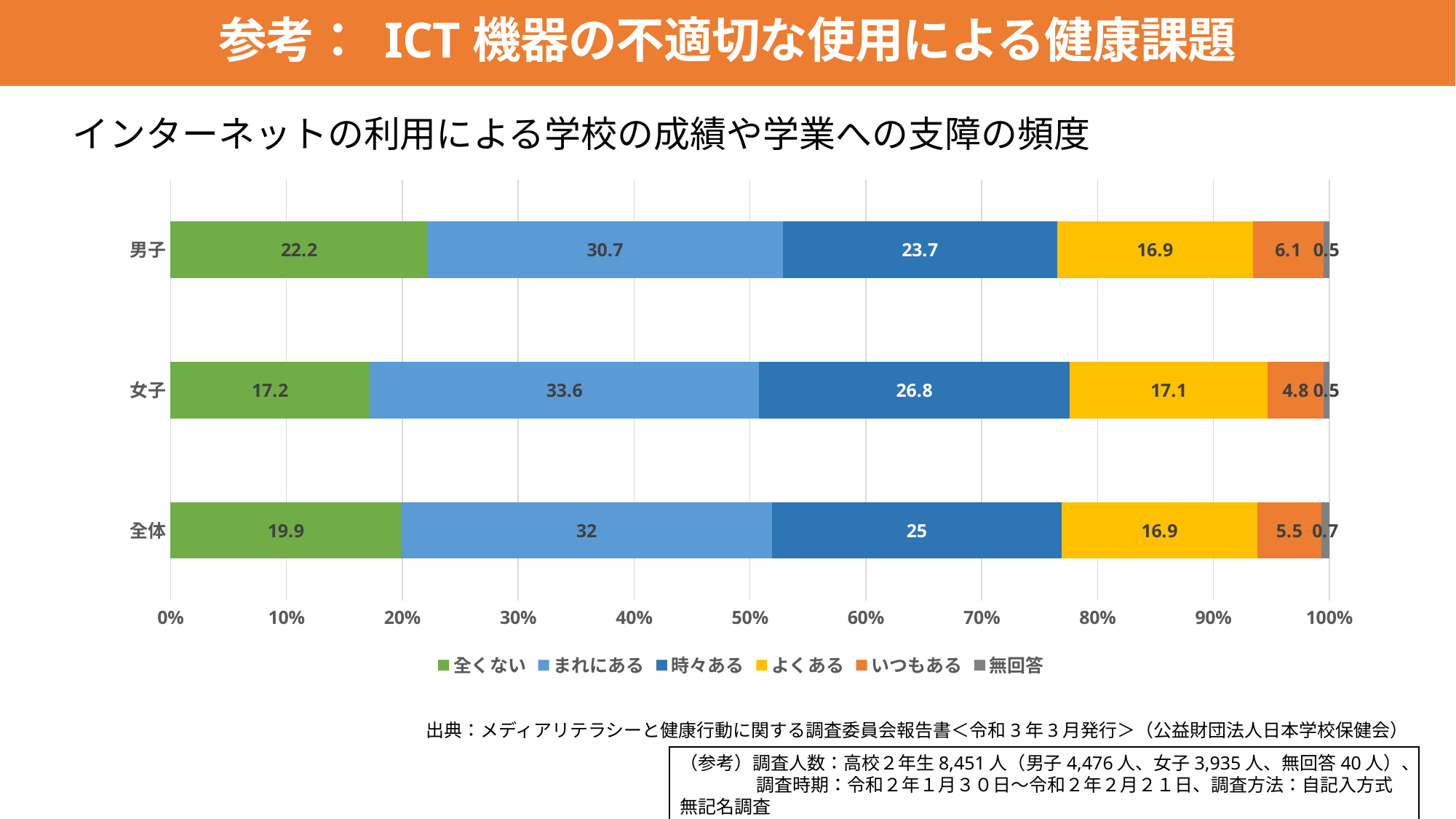
What is the value for いつもある for 男子? 6.1 What is the difference between the 全くない values for 男子 and 女子? 5 What is the value for 時々ある for 全体? 25 What is the value for 無回答 for 全体? 0.7 What is the value for 全くない for 男子? 22.2 What kind of chart is shown on the slide? Stacked bar chart Which category has the highest value for 全くない? 男子 Which is larger, the 時々ある value for 女子 or for 男子? 女子 What is the value for まれにある for 女子? 33.6 How many categories are shown on the y axis? 3 Which category has the lowest value for いつもある? 女子 How many series does the legend list? 6